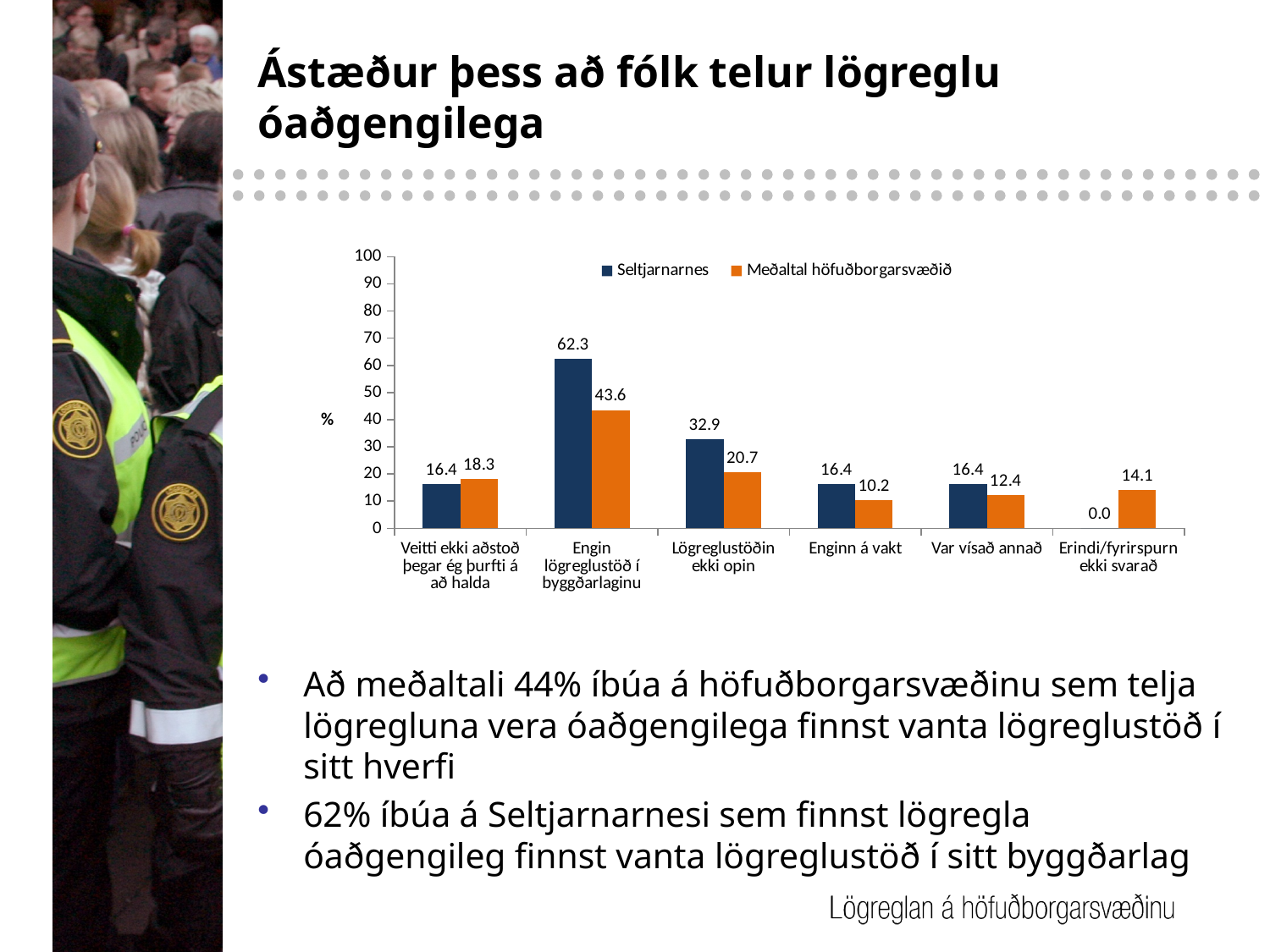
What is the difference between the Seltjarnarnes and Meðaltal höfuðborgarsvæðið values in the category "Engin lögreglustöð í byggðarlaginu"? 18.7 What is the value for Meðaltal höfuðborgarsvæðið in the category "Lögreglustöðin ekki opin"? 20.7 What is the label on the vertical axis of the chart? % What kind of chart is shown on the slide? Bar chart How many series does the chart legend list? 2 In the category "Veitti ekki aðstoð þegar ég þurfti á að halda", which series has the larger value? Meðaltal höfuðborgarsvæðið Is the Seltjarnarnes value for "Lögreglustöðin ekki opin" greater or less than 30? greater What is the value for Seltjarnarnes in the category "Erindi/fyrirspurn ekki svarað"? 0.0 What is the value for Seltjarnarnes in the category "Engin lögreglustöð í byggðarlaginu"? 62.3 Which category has the highest value for Meðaltal höfuðborgarsvæðið? Engin lögreglustöð í byggðarlaginu Which category has the lowest value for Seltjarnarnes? Erindi/fyrirspurn ekki svarað How many categories are shown on the x axis of the chart? 6